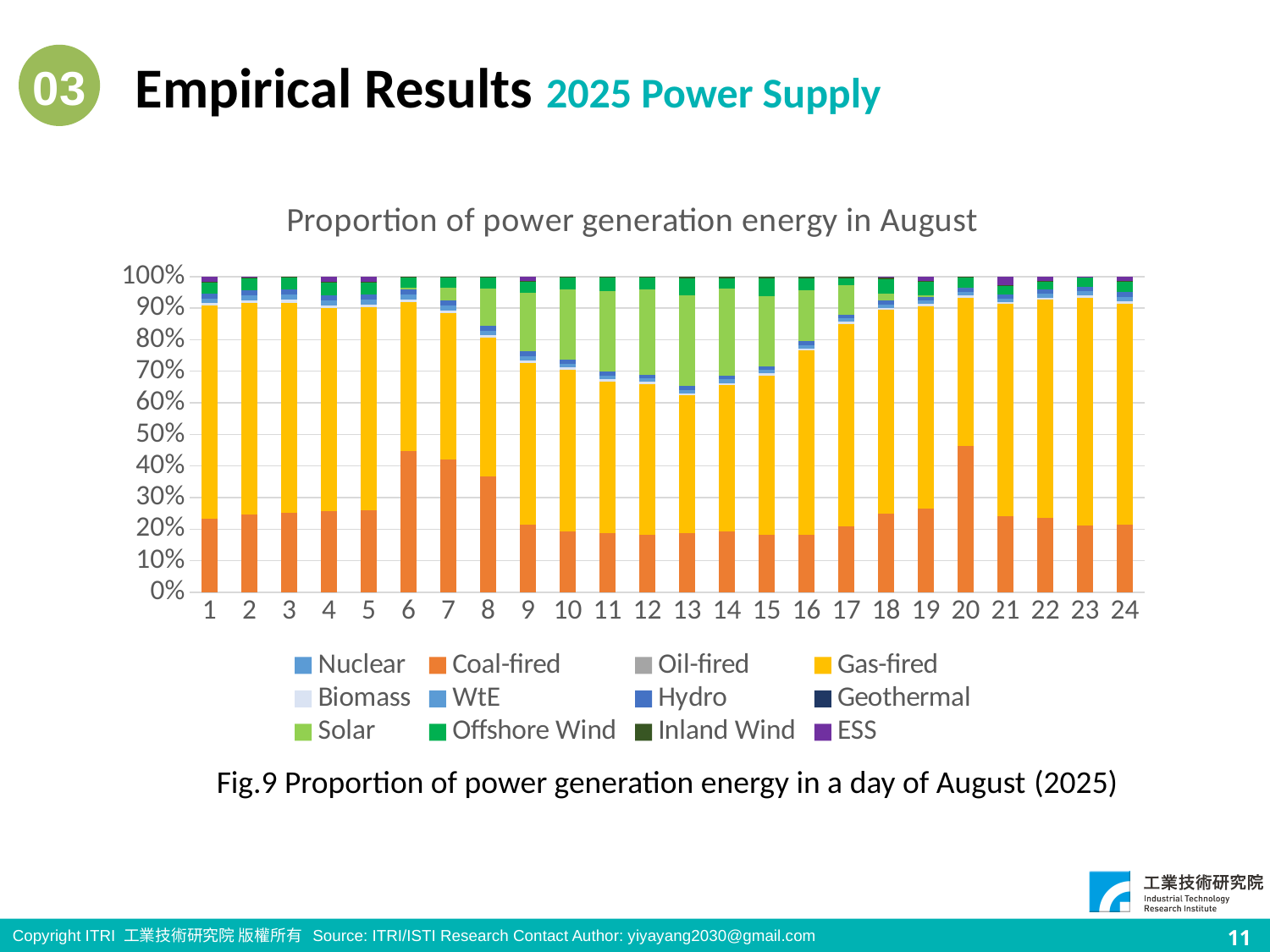
What kind of chart is shown on the slide? Stacked bar chart How many categories (hours) are shown along the x axis? 24 At which hour is the Coal-fired share the highest? 20 Is the Coal-fired share at hour 8 greater or less than 30%? greater What is the title of the chart? Proportion of power generation energy in August Is the Solar share at hour 13 greater or less than 20%? greater Does the Coal-fired share rise or fall from hour 1 to hour 6? Rises How many series does the legend list? 12 Is the Coal-fired share at hour 20 greater or less than 40%? greater Which series is drawn in yellow? Gas-fired Which has the larger Coal-fired share, hour 6 or hour 1? Hour 6